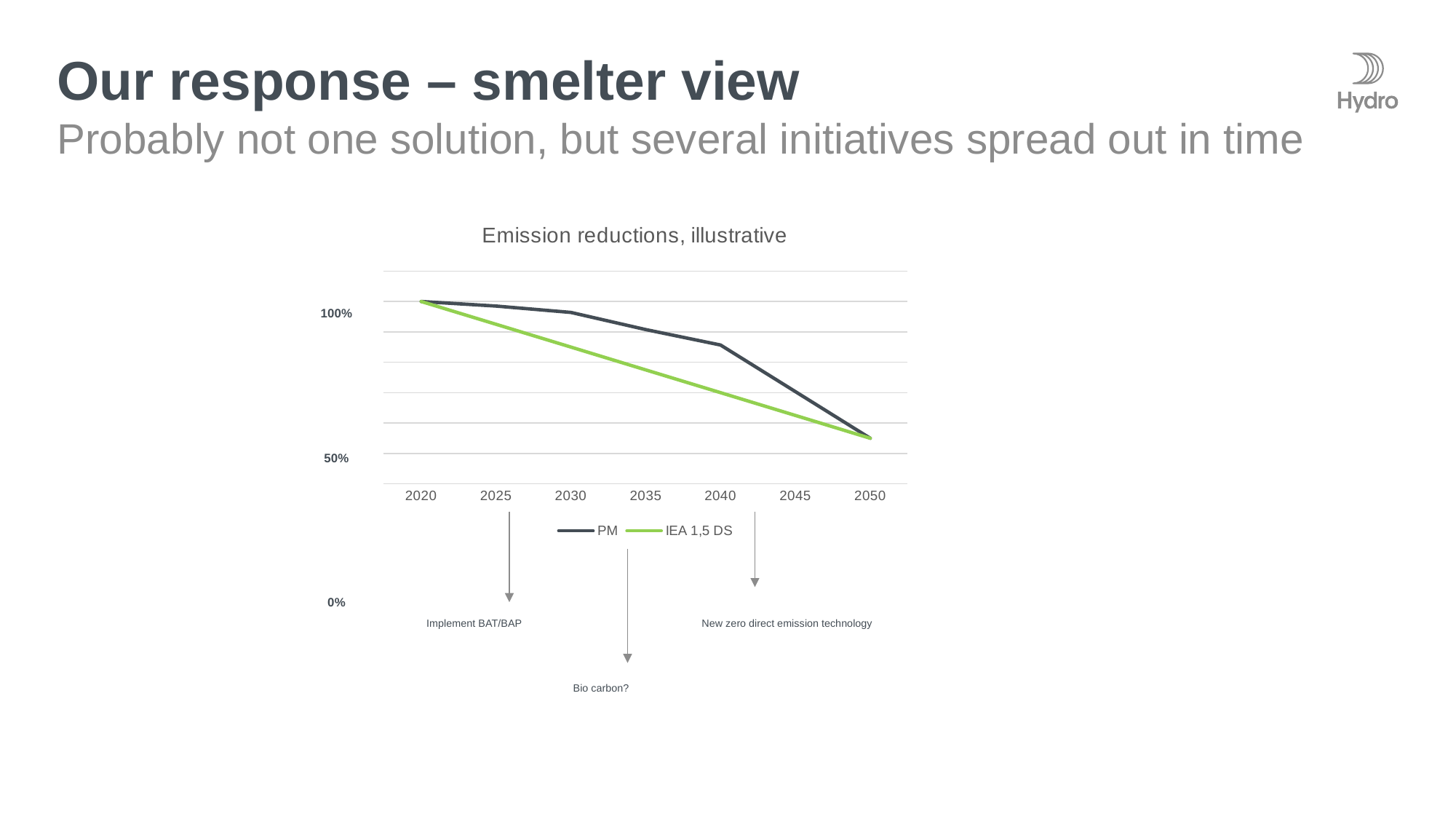
How many series does the chart's legend list? 2 What is the title of the chart? Emission reductions, illustrative In 2030, which series has the higher value, PM or IEA 1,5 DS? PM What are the two series named in the legend? PM and IEA 1,5 DS Is the value for PM in 2040 greater or less than 50%? greater How many year labels are shown along the x axis? 7 Is the value for IEA 1,5 DS in 2030 greater or less than 100%? less Does the IEA 1,5 DS line rise or fall from 2020 to 2050? Fall What kind of chart is shown on the slide? Line chart Does the PM line rise or fall from 2020 to 2050? Fall In 2040, which series has the higher value, PM or IEA 1,5 DS? PM